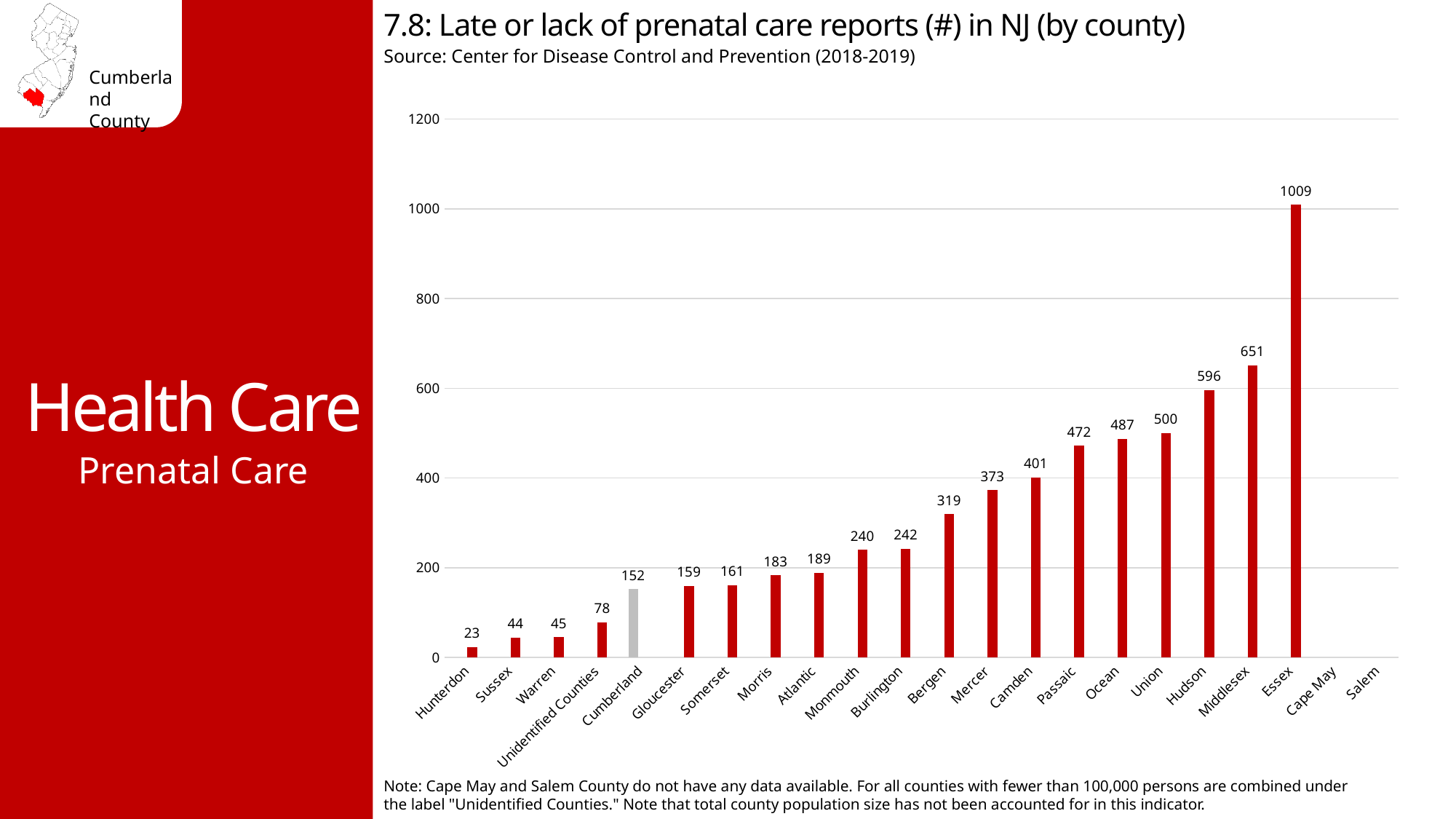
Is the value for Bergen greater or less than 400? less Do the bar values rise or fall from left to right along the x axis? rise What is the number of late or lack of prenatal care reports for Cumberland? 152 Which county's bar is coloured grey instead of red? Cumberland Which has a higher value, Camden or Mercer? Camden What is the value shown for Essex? 1009 What is the difference between the values for Middlesex and Hudson? 55 Which two counties on the x axis have no bar because no data is available? Cape May and Salem What type of chart is shown on the slide? bar chart Which county with a plotted bar has the lowest number of reports? Hunterdon What is the value shown for Hunterdon? 23 Which county has the highest number of late or lack of prenatal care reports? Essex